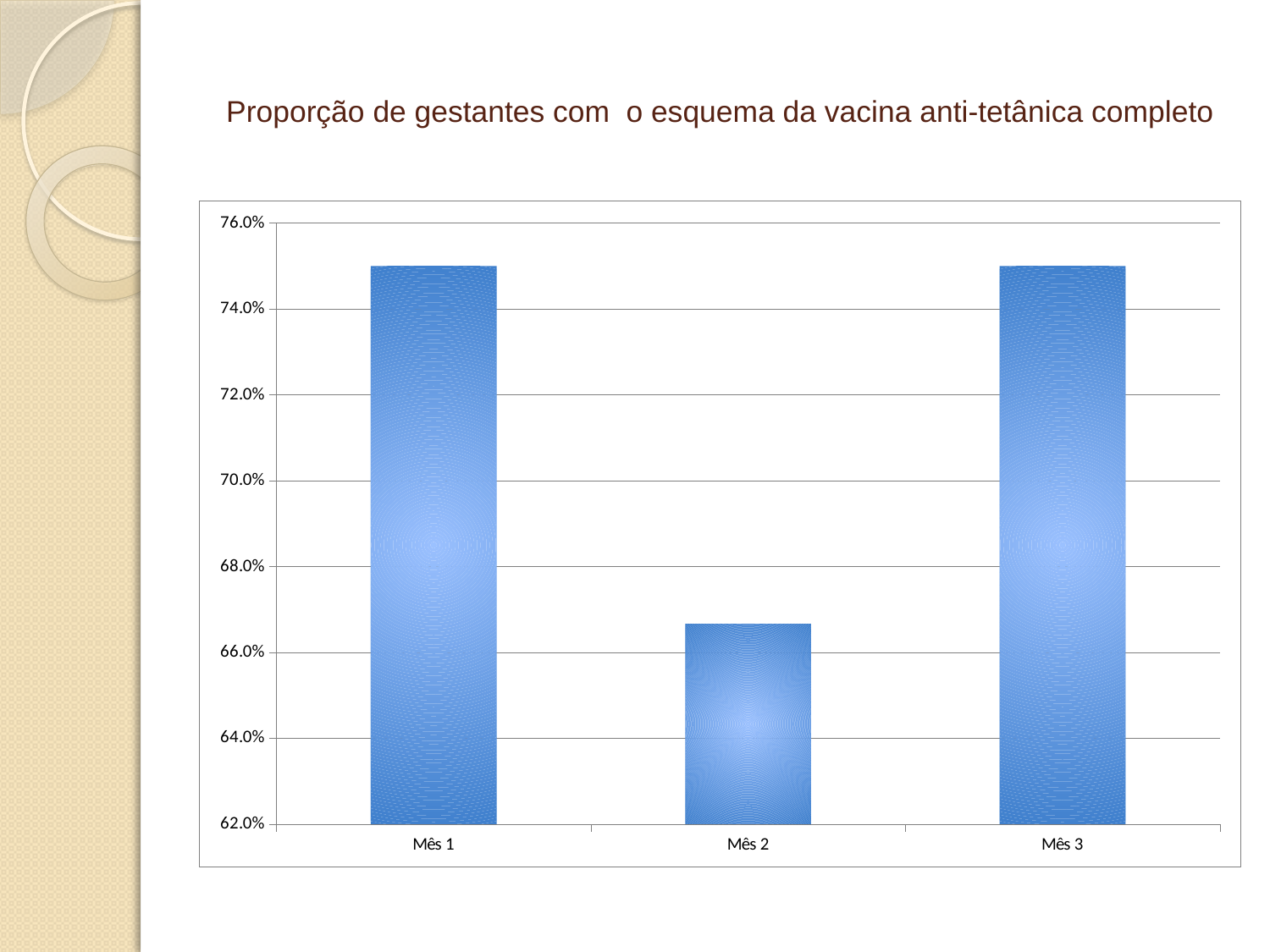
Which month has the lowest proportion in the chart? Mês 2 Which is larger, the value for Mês 1 or the value for Mês 2? Mês 1 Is the value for Mês 3 greater or less than 72.0%? greater Which is larger, the value for Mês 2 or the value for Mês 3? Mês 3 Is the value for Mês 1 greater or less than 74.0%? greater Is the value for Mês 2 greater or less than 68.0%? less What is the title of the slide above the chart? Proporção de gestantes com o esquema da vacina anti-tetânica completo How many categories are shown on the x axis of the chart? 3 Does the value fall or rise from Mês 1 to Mês 2? fall What kind of chart is shown on the slide? bar chart What is the lowest value shown on the y axis of the chart? 62.0%